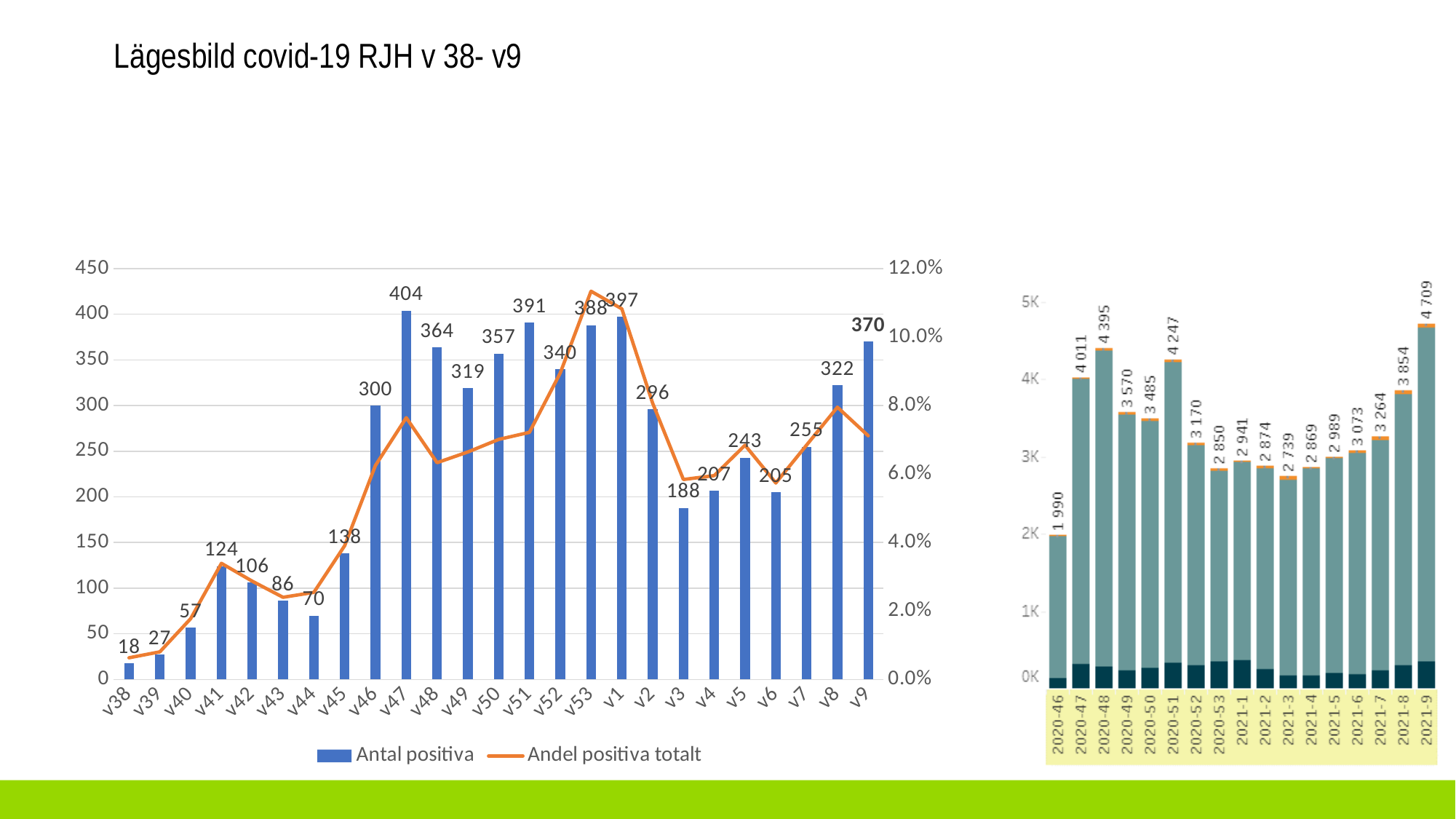
How many bars are shown in the right chart? 17 In the left chart, which week has the highest Antal positiva? v47 In the left chart, what is the difference in Antal positiva between v8 and v7? 67 In the left chart, what is the value of Antal positiva for v47? 404 In the left chart, what is the value of Antal positiva for v9? 370 In the left chart, which week has more Antal positiva, v2 or v5? v2 In the right chart, what is the total labelled for 2021-9? 4 709 In the right chart, which week has the lowest labelled total? 2020-46 In the left chart, is the Andel positiva totalt value for v53 greater or less than 10.0%? greater How many series does the legend of the left chart list? 2 In the left chart, which week has the lowest Antal positiva? v38 How many weeks are shown on the x axis of the left chart? 25